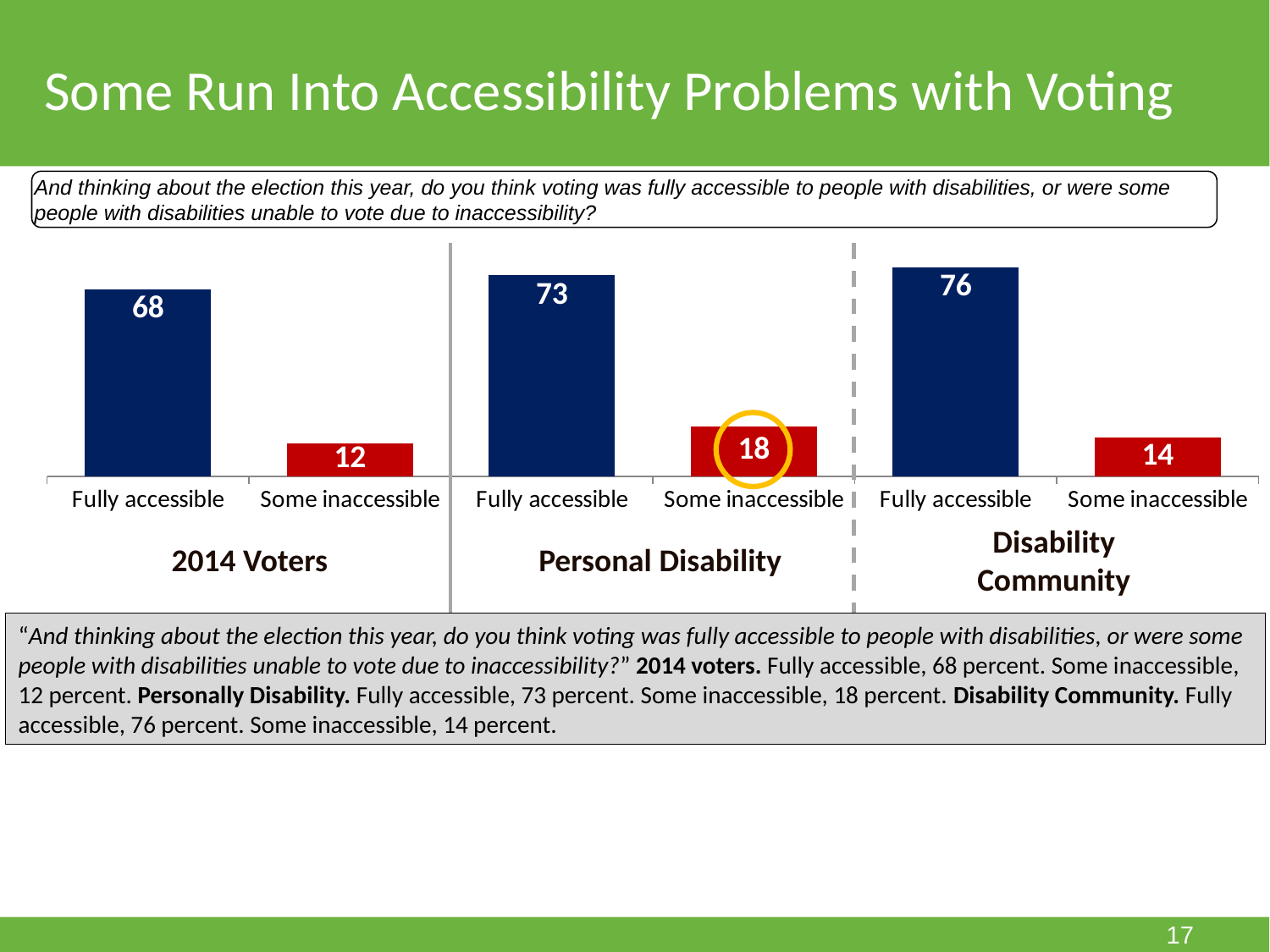
What is the difference between the Fully accessible values for Disability Community and 2014 Voters? 8 Which group has the lowest Some inaccessible value? 2014 Voters What is the difference between Fully accessible and Some inaccessible in the Personal Disability group? 55 Which group has the highest Fully accessible value? Disability Community What is the value for Some inaccessible in the Personal Disability group? 18 What is the value for Fully accessible among 2014 Voters? 68 Which bar is circled in yellow on the chart? Some inaccessible, Personal Disability (18) What is the value for Some inaccessible among 2014 Voters? 12 Which is larger: Some inaccessible for Personal Disability or Some inaccessible for Disability Community? Personal Disability How many bars are plotted in the chart? 6 What is the value for Fully accessible in the Disability Community group? 76 What kind of chart is shown on the slide? Bar chart